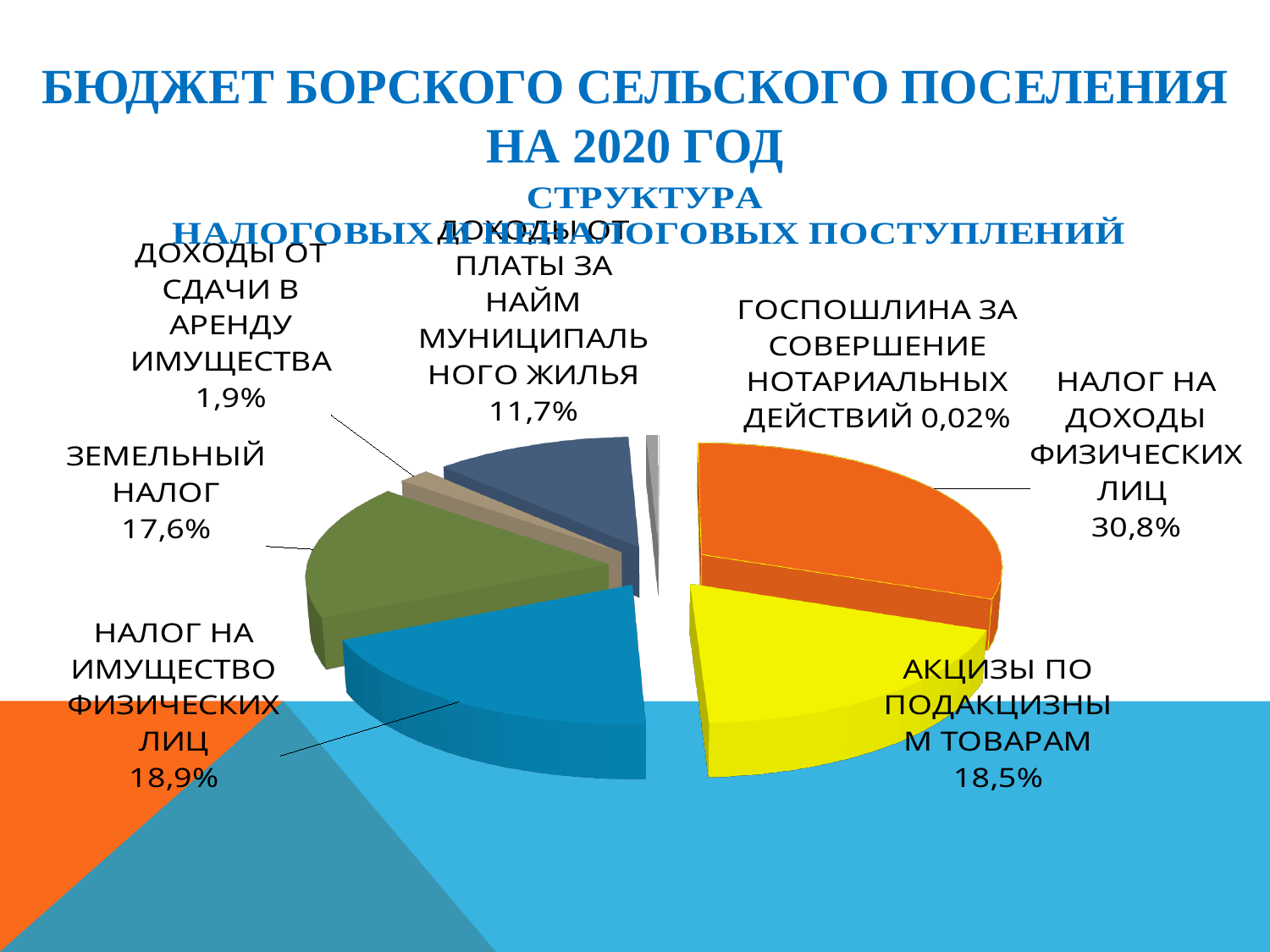
What colour is the slice for Акцизы по подакцизным товарам? Yellow How many categories are shown in the pie chart? 8 What percentage is shown for Доходы от платы за найм муниципального жилья? 11,7% What value is labelled for Госпошлина за совершение нотариальных действий? 0,02% What kind of chart is shown on the slide? Pie chart Which category has the smallest share of the pie? Госпошлина за совершение нотариальных действий What is the difference between the shares of Налог на доходы физических лиц and Акцизы по подакцизным товарам? 12,3% What is the value shown for Земельный налог? 17,6% What is the difference between the shares of Доходы от платы за найм муниципального жилья and Доходы от сдачи в аренду имущества? 9,8% Which category has the largest share of the pie? Налог на доходы физических лиц What share of the pie does Налог на доходы физических лиц have? 30,8% Which is larger: the share for Налог на имущество физических лиц or the share for Земельный налог? Налог на имущество физических лиц